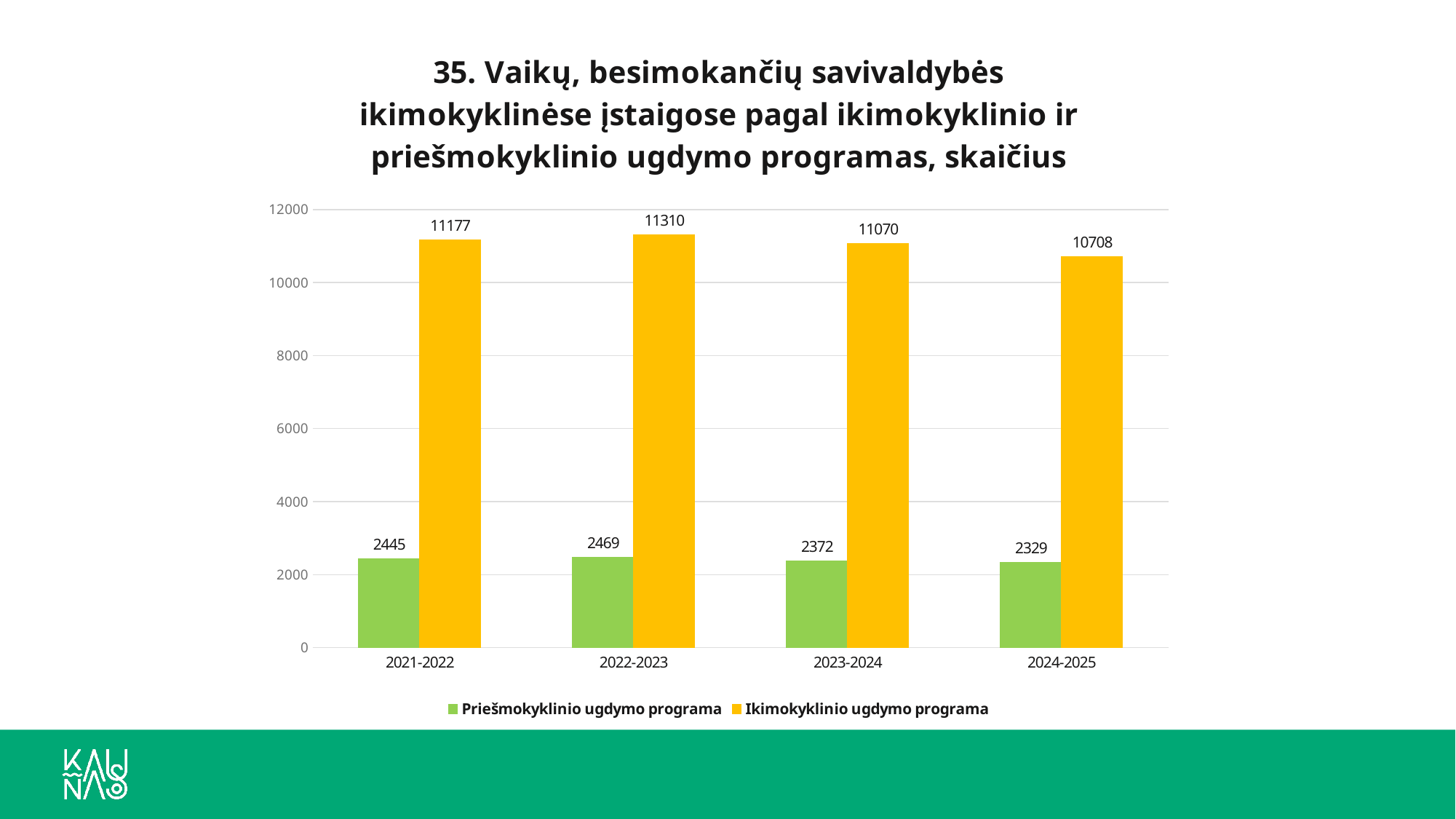
Is the Ikimokyklinio ugdymo programa value for 2024-2025 greater or less than 10000? greater What is the difference between the Ikimokyklinio ugdymo programa values in 2022-2023 and 2024-2025? 602 Which colour represents Priešmokyklinio ugdymo programa in the legend? green In which school year is the Priešmokyklinio ugdymo programa value lowest? 2024-2025 What kind of chart is shown on the slide? bar chart What is the value for Ikimokyklinio ugdymo programa in 2021-2022? 11177 What is the value for Ikimokyklinio ugdymo programa in 2022-2023? 11310 How many school years are shown on the x axis? 4 What is the value for Priešmokyklinio ugdymo programa in 2024-2025? 2329 Which is larger: the Priešmokyklinio ugdymo programa value in 2021-2022 or in 2023-2024? 2021-2022 How many series does the legend list? 2 In which school year is the Ikimokyklinio ugdymo programa value highest? 2022-2023